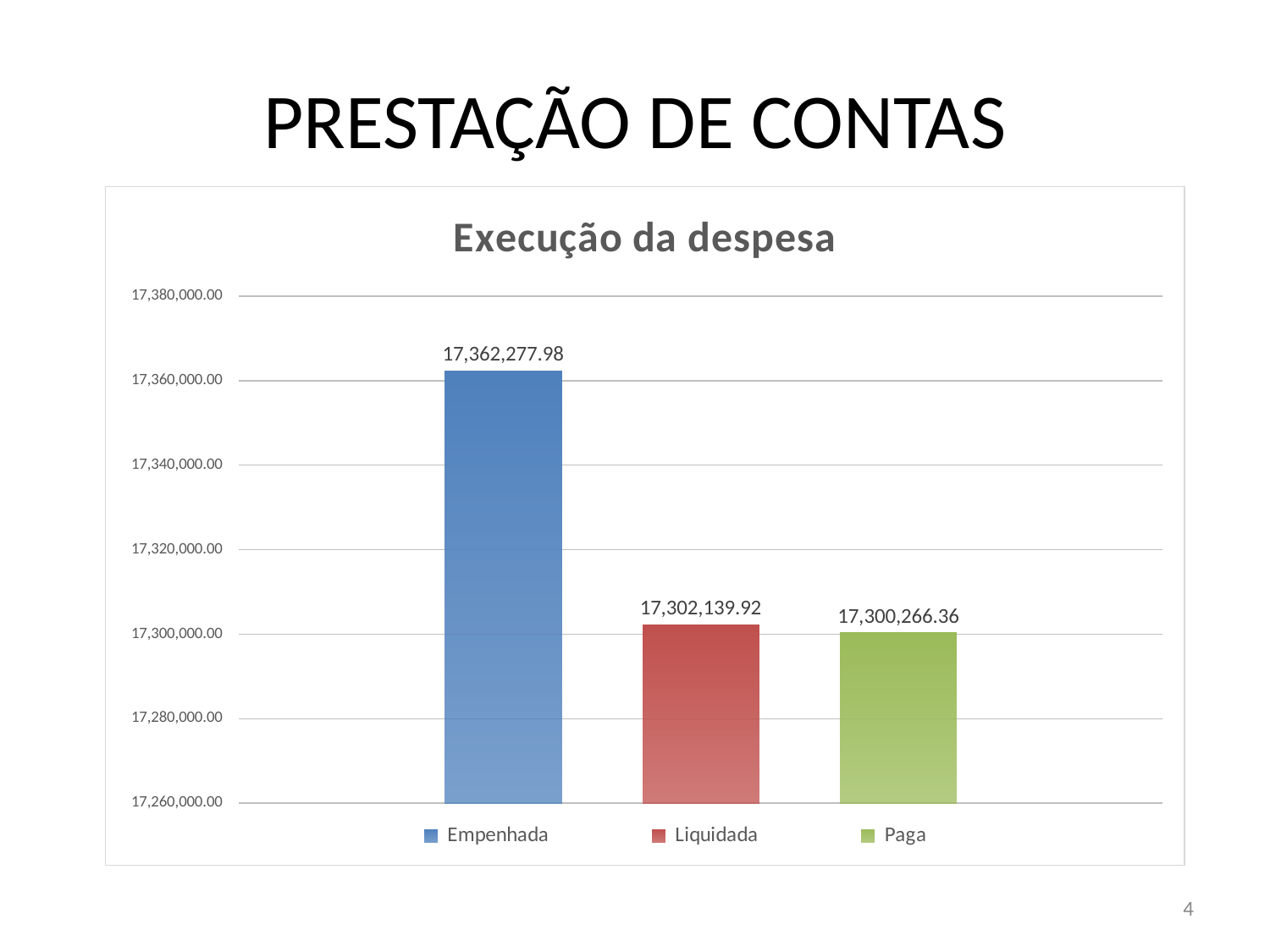
What type of chart is shown on the slide? Bar chart What is the value of the Liquidada bar? 17,302,139.92 How many bars are shown in the chart? 3 What is the difference between the Empenhada and Liquidada values? 60,138.06 Is the value for Empenhada greater or less than 17,340,000.00? greater What is the value of the Paga bar? 17,300,266.36 What is the value of the Empenhada bar in the Execução da despesa chart? 17,362,277.98 What is the title of the chart? Execução da despesa Which is larger, the Liquidada value or the Paga value? Liquidada Which category has the highest value in the chart? Empenhada What is the difference between the Liquidada and Paga values? 1,873.56 Which category has the lowest value in the chart? Paga